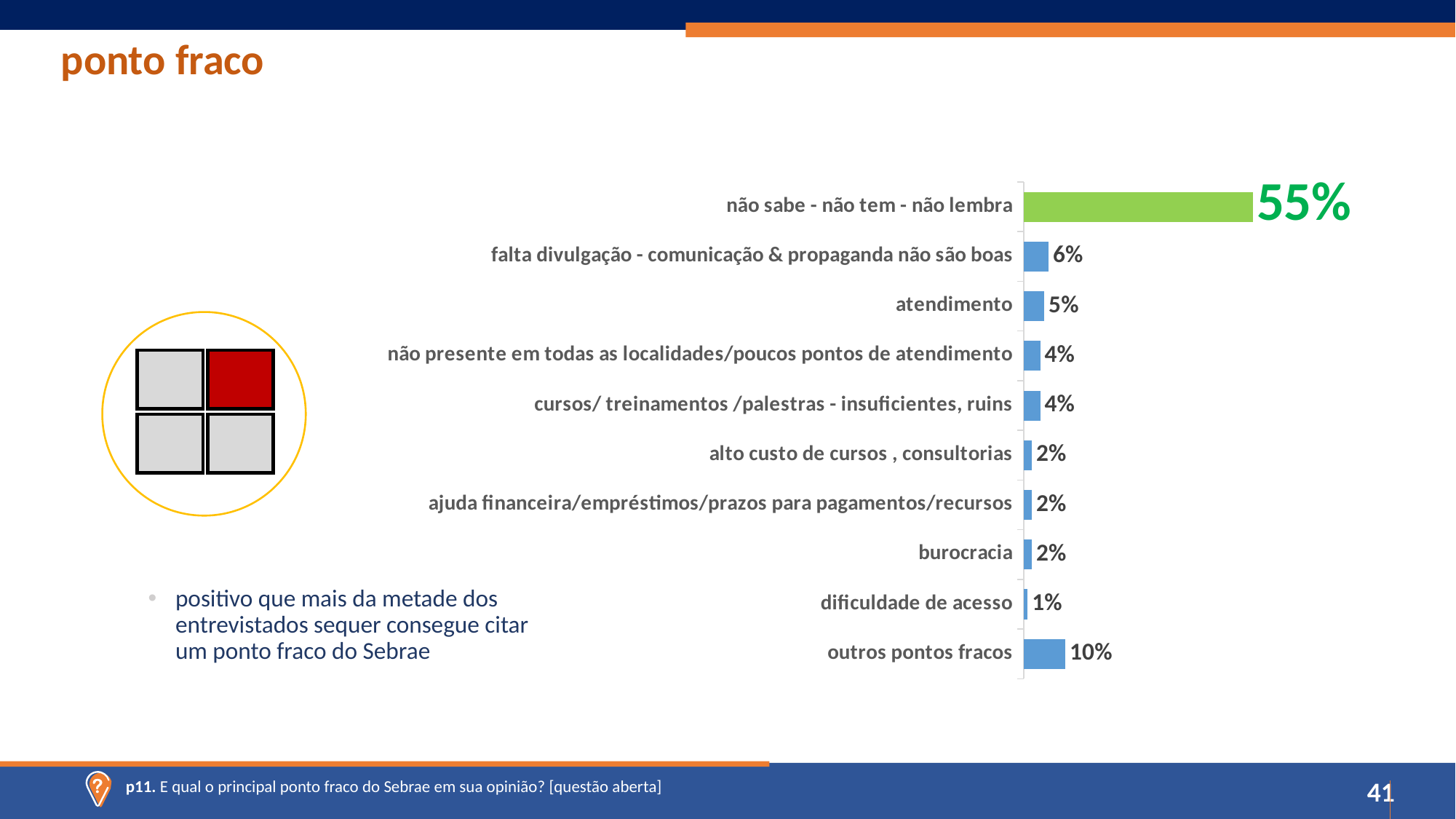
What is the value for 'outros pontos fracos'? 10% What is the value for 'atendimento'? 5% Which category has the lowest value? dificuldade de acesso Which is larger: 'atendimento' or 'burocracia'? atendimento How many categories are shown in the chart? 10 What is the value for 'falta divulgação - comunicação & propaganda não são boas'? 6% What is the difference between 'não sabe - não tem - não lembra' and 'outros pontos fracos'? 45% What is the value for 'não sabe - não tem - não lembra'? 55% Which category has the highest value? não sabe - não tem - não lembra Which bar is coloured green rather than blue? não sabe - não tem - não lembra What kind of chart is shown on the slide? bar chart What is the value for 'dificuldade de acesso'? 1%